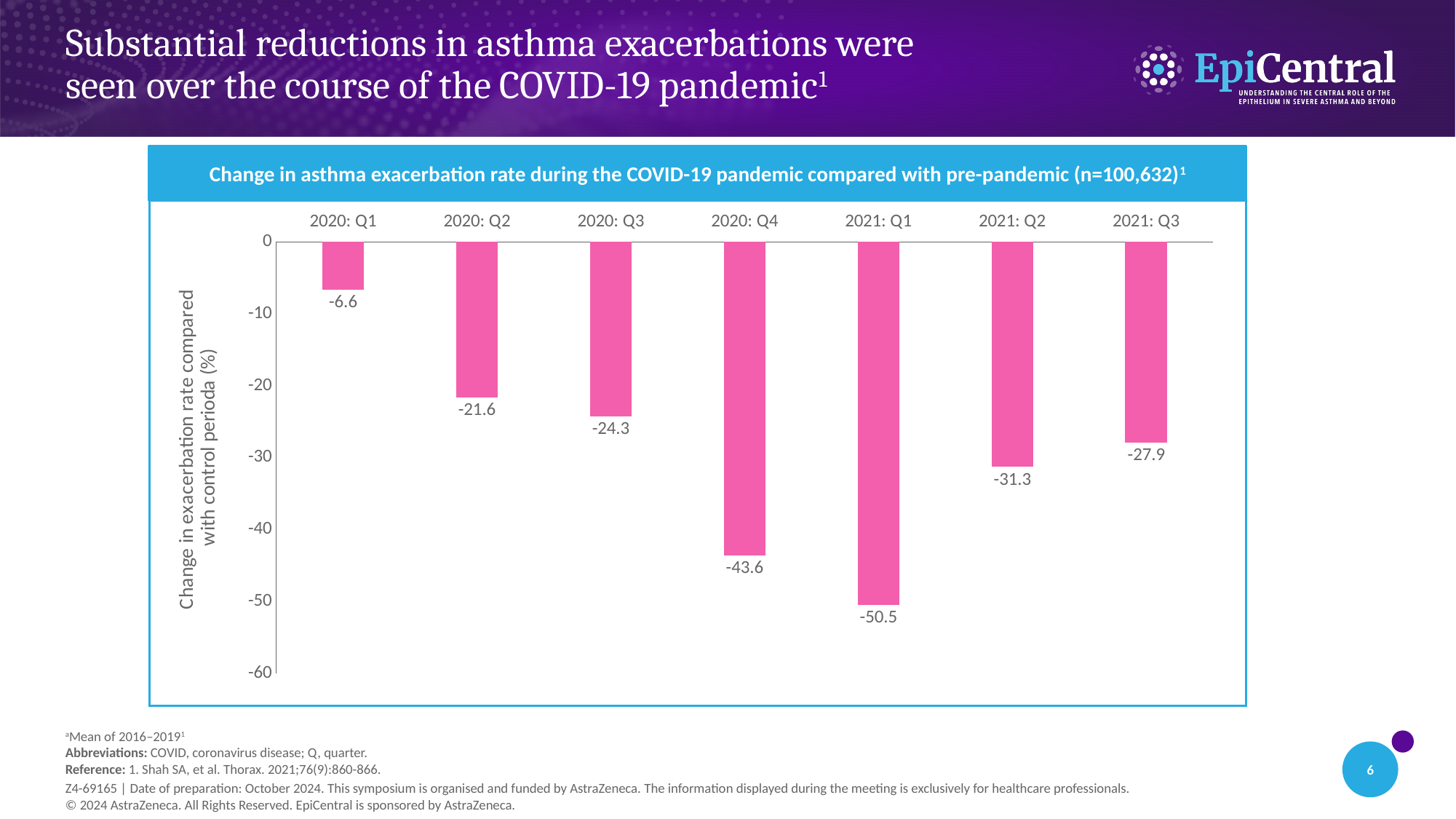
What is the change in asthma exacerbation rate for 2020: Q1? -6.6 What type of chart is shown on the slide? Bar chart What is the sample size (n) given in the chart title? n=100,632 Does the change in exacerbation rate fall or rise from 2020: Q1 to 2021: Q1? Fall Which quarter has a larger reduction in exacerbation rate, 2021: Q2 or 2021: Q3? 2021: Q2 What is the change in asthma exacerbation rate for 2021: Q3? -27.9 Which quarter shows the largest reduction in asthma exacerbation rate? 2021: Q1 What is the change in asthma exacerbation rate for 2021: Q1? -50.5 Which quarter shows the smallest reduction in asthma exacerbation rate? 2020: Q1 What is the difference between the values for 2020: Q2 and 2020: Q3? 2.7 What is the change in asthma exacerbation rate for 2020: Q4? -43.6 How many quarters are plotted on the chart? 7